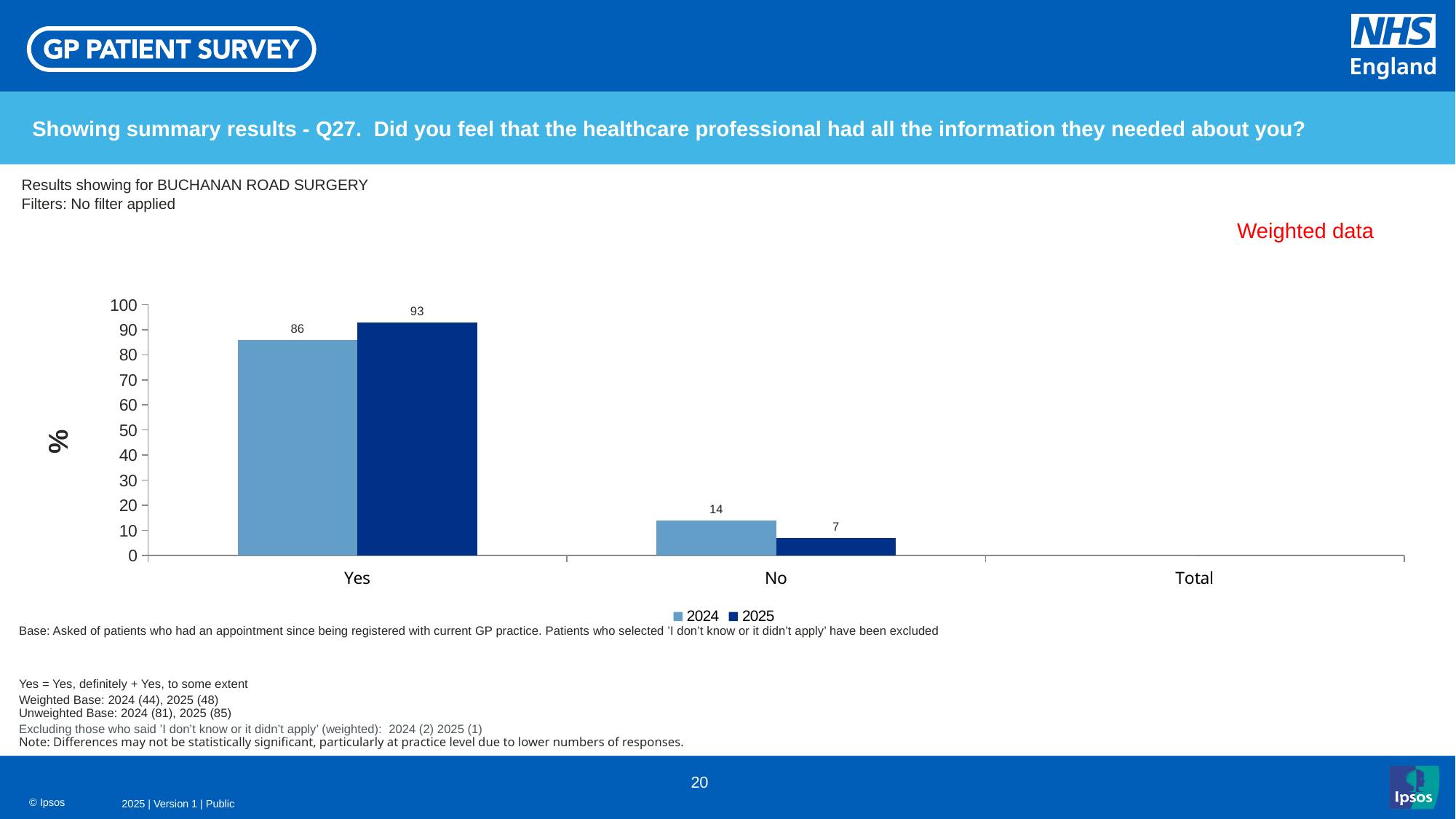
What kind of chart is shown on the slide? Bar chart Which category has the lowest value for 2024? No Which is larger for Yes: the 2024 value or the 2025 value? 2025 How many series does the legend list? 2 What label is shown on the vertical axis? % What is the difference between the 2024 and 2025 values for No? 7 Which category has the highest value for 2025? Yes What is the value for Yes in 2024? 86 What is the value for No in 2025? 7 What is the value for No in 2024? 14 What is the difference between the 2025 and 2024 values for Yes? 7 What is the value for Yes in 2025? 93